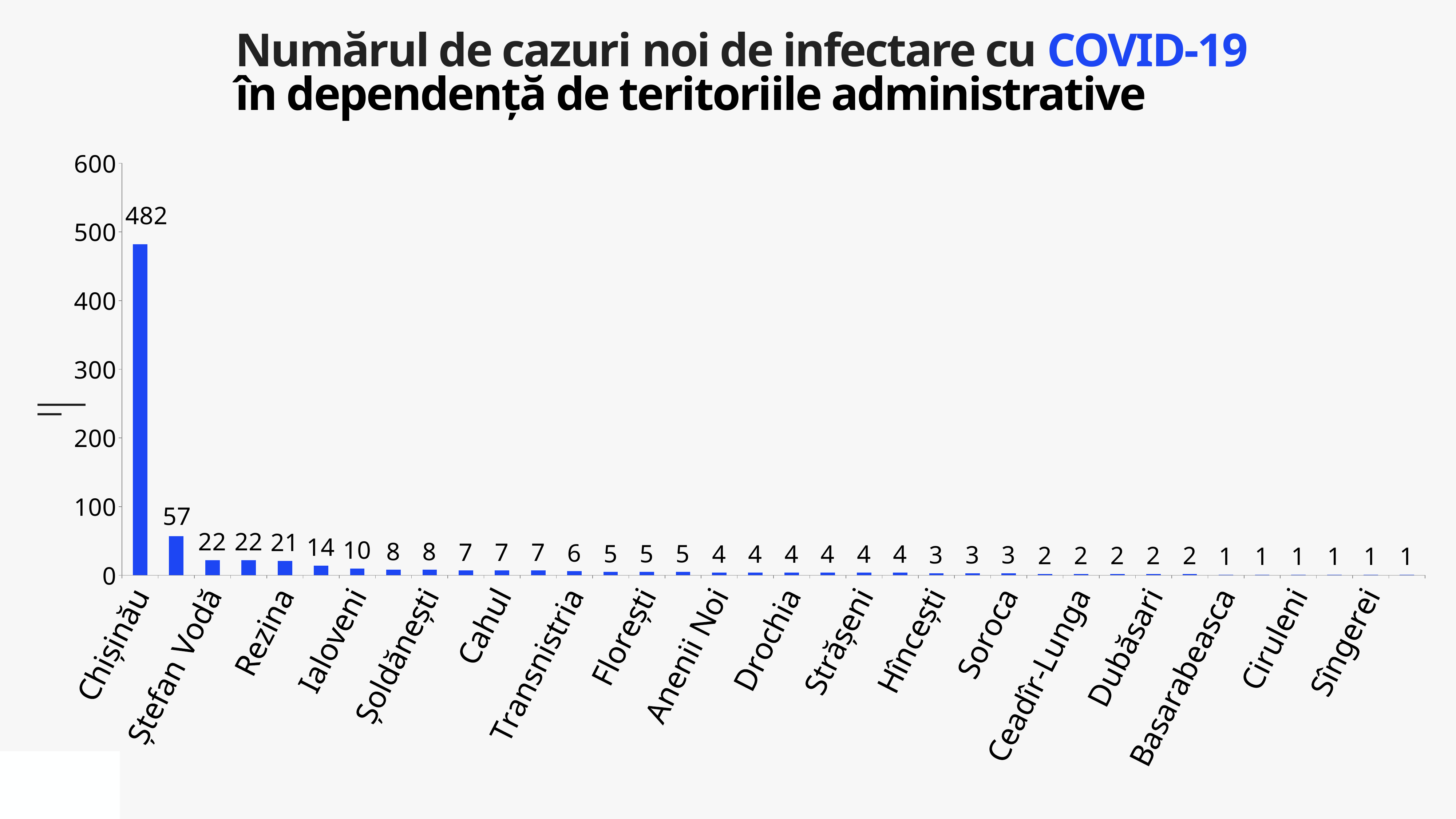
How many bars are plotted on the chart? 36 What kind of chart is shown on the slide? bar chart What is the difference between the highest bar (482) and the second-highest bar (57)? 425 Is the value for Chișinău greater or less than 400? greater What is the smallest value shown on the chart? 1 Which administrative territory has the highest number of new cases? Chișinău Do the values rise or fall moving from left to right along the x axis? fall What is the second-highest value shown on the chart? 57 What colour are the bars on the chart? blue How many new COVID-19 cases are shown for Chișinău? 482 What is the highest tick value on the vertical axis? 600 Is the value for Chișinău greater or less than 500? less